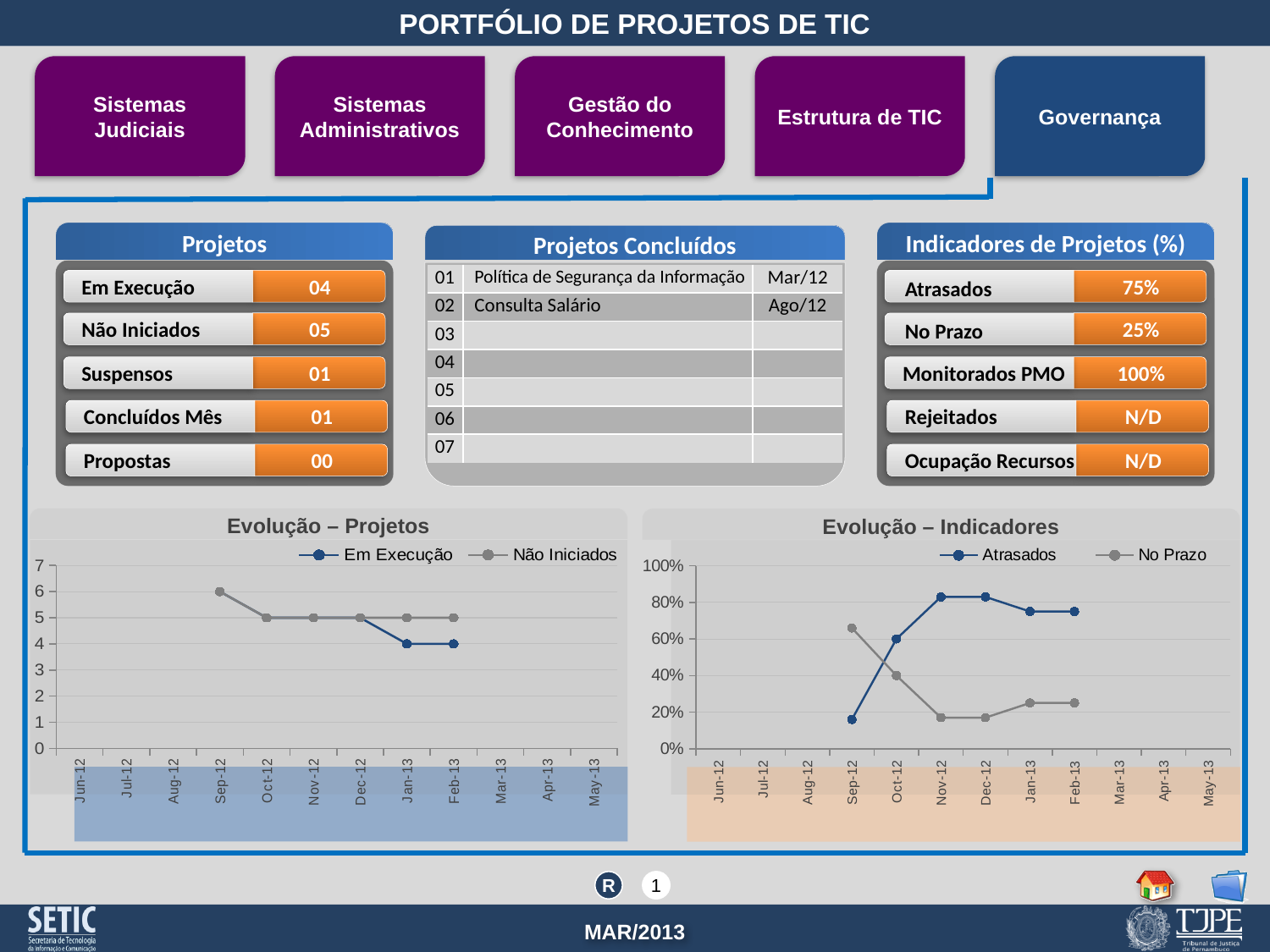
What kind of chart is the "Evolução – Projetos" chart? line chart In the "Evolução – Projetos" chart, what is the value of Não Iniciados in Sep-12? 6 In the "Evolução – Indicadores" chart, what is the value of Atrasados in Oct-12? 60% In the "Evolução – Indicadores" chart, how many series does the legend list? 2 In the "Evolução – Projetos" chart, what is the value of Em Execução in Jan-13? 4 In the "Evolução – Indicadores" chart, does No Prazo rise or fall from Sep-12 to Nov-12? fall In the "Evolução – Projetos" chart, does Em Execução rise or fall from Dec-12 to Feb-13? fall In the "Evolução – Projetos" chart, how many series does the legend list? 2 In the "Evolução – Indicadores" chart, what is the difference between Atrasados and No Prazo in Oct-12? 20% In the "Evolução – Projetos" chart, in which month is Não Iniciados highest? Sep-12 In the "Evolução – Projetos" chart, which series has the larger value in Feb-13, Em Execução or Não Iniciados? Não Iniciados In the "Evolução – Indicadores" chart, is the value for Atrasados in Nov-12 greater or less than 80%? greater